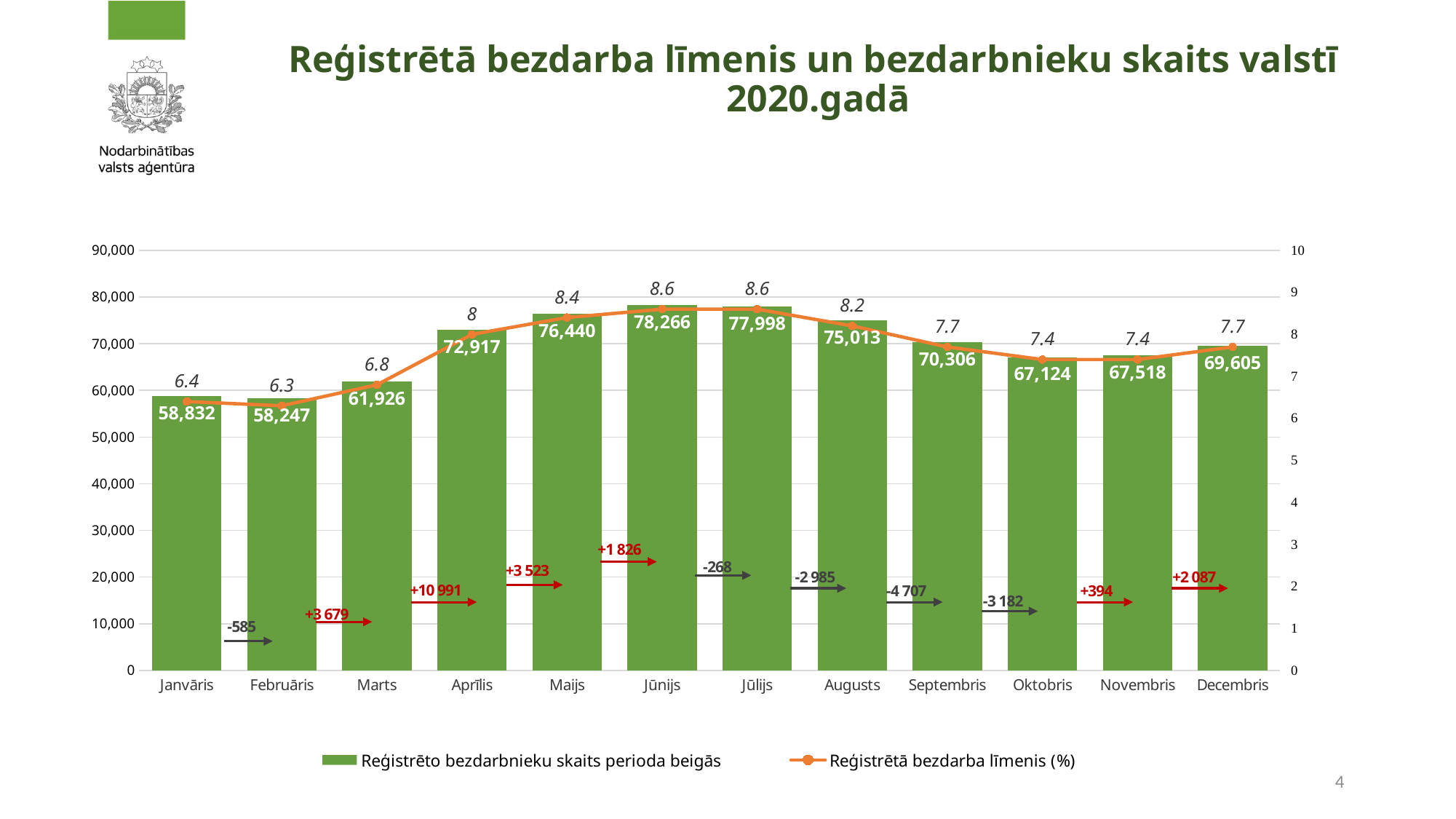
How many months are shown on the x axis? 12 What is the value of Reģistrēto bezdarbnieku skaits perioda beigās for Jūnijs? 78,266 What is the value of Reģistrēto bezdarbnieku skaits perioda beigās for Decembris? 69,605 What kind of chart is used for the Reģistrēto bezdarbnieku skaits perioda beigās series? Bar chart What is the Reģistrētā bezdarba līmenis (%) for Aprīlis? 8 Which month has the highest Reģistrēto bezdarbnieku skaits perioda beigās? Jūnijs What is the difference in Reģistrēto bezdarbnieku skaits perioda beigās between Jūnijs and Jūlijs? 268 Is the Reģistrēto bezdarbnieku skaits perioda beigās for Marts greater or less than 60,000? greater Which month has the lowest Reģistrēto bezdarbnieku skaits perioda beigās? Februāris Which is larger, the Reģistrēto bezdarbnieku skaits perioda beigās for Oktobris or for Novembris? Novembris Does the Reģistrētā bezdarba līmenis (%) rise or fall from Jūlijs to Oktobris? Fall How many series does the legend list? 2